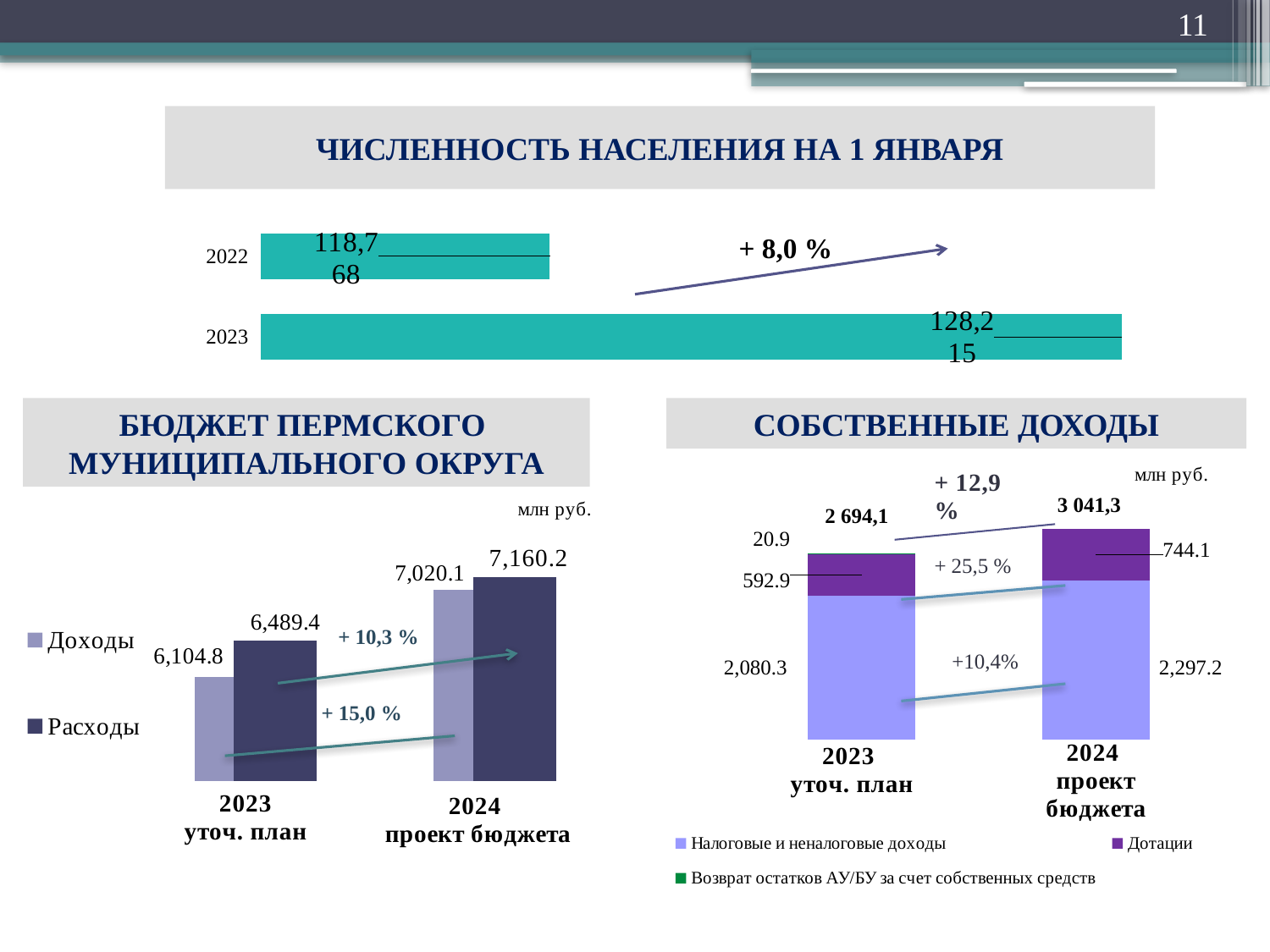
In the chart titled 'ЧИСЛЕННОСТЬ НАСЕЛЕНИЯ НА 1 ЯНВАРЯ', what kind of chart is shown? bar chart In the chart titled 'БЮДЖЕТ ПЕРМСКОГО МУНИЦИПАЛЬНОГО ОКРУГА', what is the difference between Расходы and Доходы for 2024 проект бюджета? 140.1 In the chart titled 'СОБСТВЕННЫЕ ДОХОДЫ', how many series does the legend list? 3 In the chart titled 'БЮДЖЕТ ПЕРМСКОГО МУНИЦИПАЛЬНОГО ОКРУГА', how many series does the legend list? 2 In the chart titled 'СОБСТВЕННЫЕ ДОХОДЫ', what is the total of the stacked bar for 2023 уточ. план? 2 694,1 In the chart titled 'ЧИСЛЕННОСТЬ НАСЕЛЕНИЯ НА 1 ЯНВАРЯ', which year has the larger population, 2022 or 2023? 2023 In the chart titled 'БЮДЖЕТ ПЕРМСКОГО МУНИЦИПАЛЬНОГО ОКРУГА', what is the value of Доходы for 2023 уточ. план? 6,104.8 In the chart titled 'СОБСТВЕННЫЕ ДОХОДЫ', what is the value of Налоговые и неналоговые доходы for 2024 проект бюджета? 2,297.2 In the chart titled 'СОБСТВЕННЫЕ ДОХОДЫ', what is the difference in Дотации between 2024 проект бюджета and 2023 уточ. план? 151.2 In the chart titled 'БЮДЖЕТ ПЕРМСКОГО МУНИЦИПАЛЬНОГО ОКРУГА', do the Доходы values rise or fall from 2023 to 2024? rise In the chart titled 'БЮДЖЕТ ПЕРМСКОГО МУНИЦИПАЛЬНОГО ОКРУГА', what is the value of Расходы for 2024 проект бюджета? 7,160.2 In the chart titled 'ЧИСЛЕННОСТЬ НАСЕЛЕНИЯ НА 1 ЯНВАРЯ', what percentage change is shown between 2022 and 2023? + 8,0 %